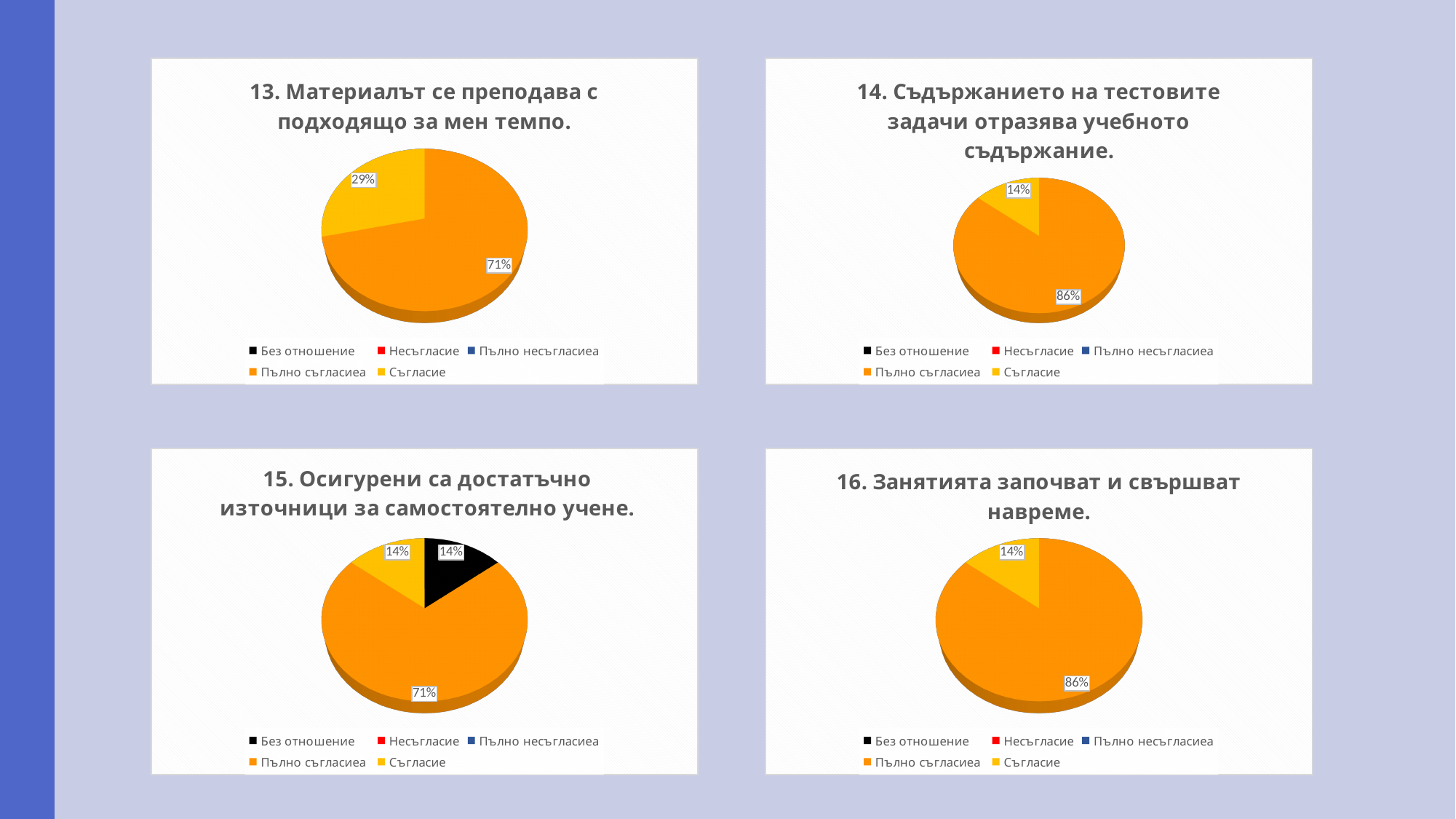
In the chart titled "13. Материалът се преподава с подходящо за мен темпо.", what share does the "Съгласие" slice have? 29% In the chart titled "13. Материалът се преподава с подходящо за мен темпо.", what share does the "Пълно съгласиеа" slice have? 71% In the chart titled "13. Материалът се преподава с подходящо за мен темпо.", what is the difference between the "Пълно съгласиеа" and "Съгласие" slices? 42% In the chart titled "15. Осигурени са достатъчно източници за самостоятелно учене.", how many slices are shown in the pie? 3 In the chart titled "15. Осигурени са достатъчно източници за самостоятелно учене.", what share does the "Без отношение" slice have? 14% In the chart titled "15. Осигурени са достатъчно източници за самостоятелно учене.", which category has the largest slice? Пълно съгласиеа In the chart titled "14. Съдържанието на тестовите задачи отразява учебното съдържание.", what is the value of the "Пълно съгласиеа" slice? 86% In the chart titled "14. Съдържанието на тестовите задачи отразява учебното съдържание.", what is the value of the "Съгласие" slice? 14% In the chart titled "16. Занятията започват и свършват навреме.", which is larger, the "Пълно съгласиеа" slice or the "Съгласие" slice? Пълно съгласиеа What type of chart is used in the chart titled "13. Материалът се преподава с подходящо за мен тempo."? Pie chart How many entries does the legend list in the chart titled "14. Съдържанието на тестовите задачи отразява учебното съдържание."? 5 In the chart titled "16. Занятията започват и свършват навреме.", what is the difference between the "Пълно съгласиеа" and "Съгласие" slices? 72%